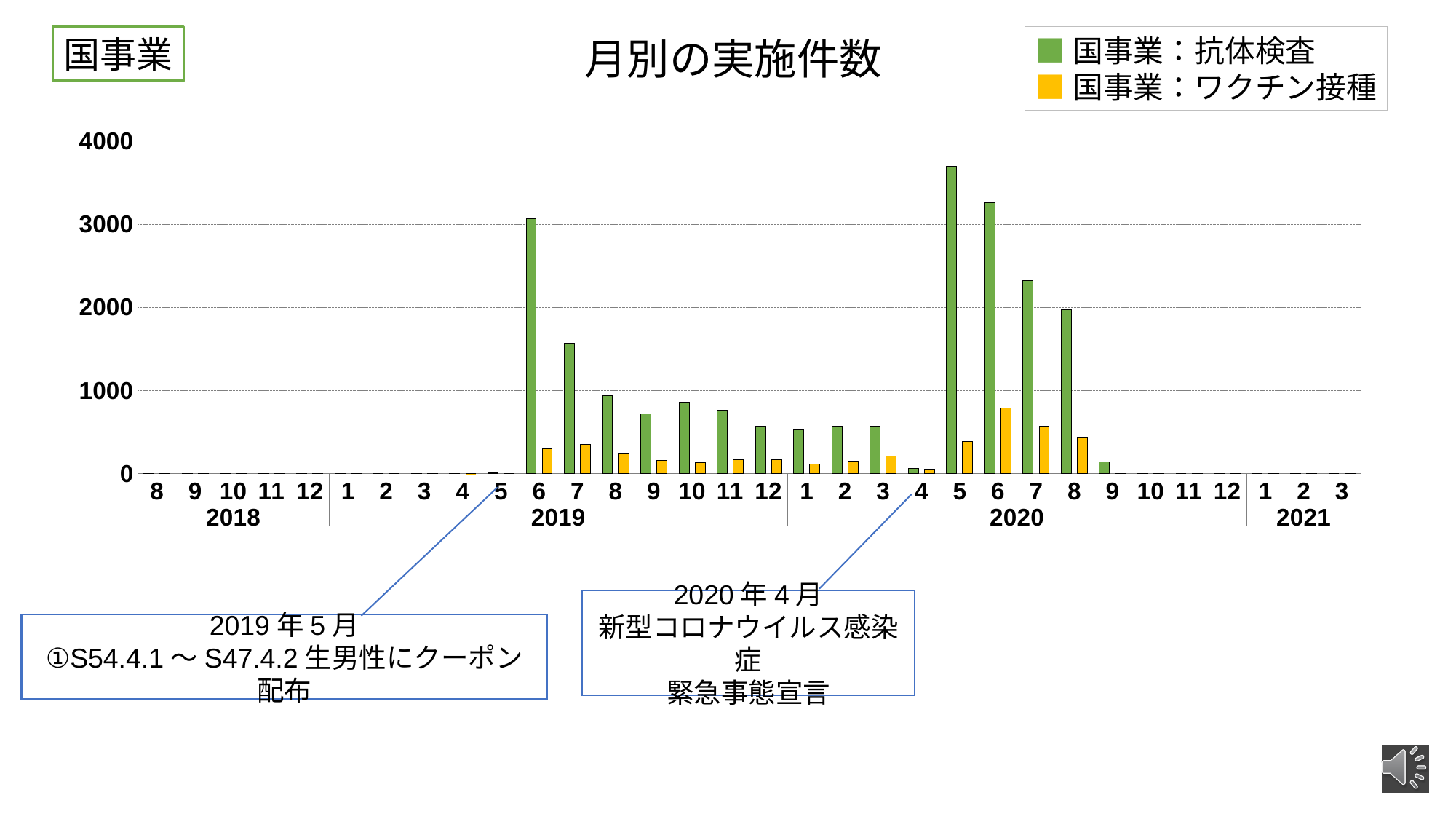
How many series does the legend list? 2 How many months are shown on the x axis? 32 Which is larger, the 国事業：抗体検査 value for 2020年5月 or for 2020年6月? 2020年5月 In which month is the 国事業：抗体検査 value highest? 2020年5月 What kind of chart is shown on the slide? bar chart Which is larger, the 国事業：抗体検査 value for 2019年7月 or for 2019年8月? 2019年7月 Which series is shown in green in the legend? 国事業：抗体検査 Is the 国事業：ワクチン接種 value for 2020年6月 greater or less than 1000? less In which month is the 国事業：ワクチン接種 value highest? 2020年6月 Is the 国事業：抗体検査 value for 2020年7月 greater or less than 2000? greater What is the title of the chart? 月別の実施件数